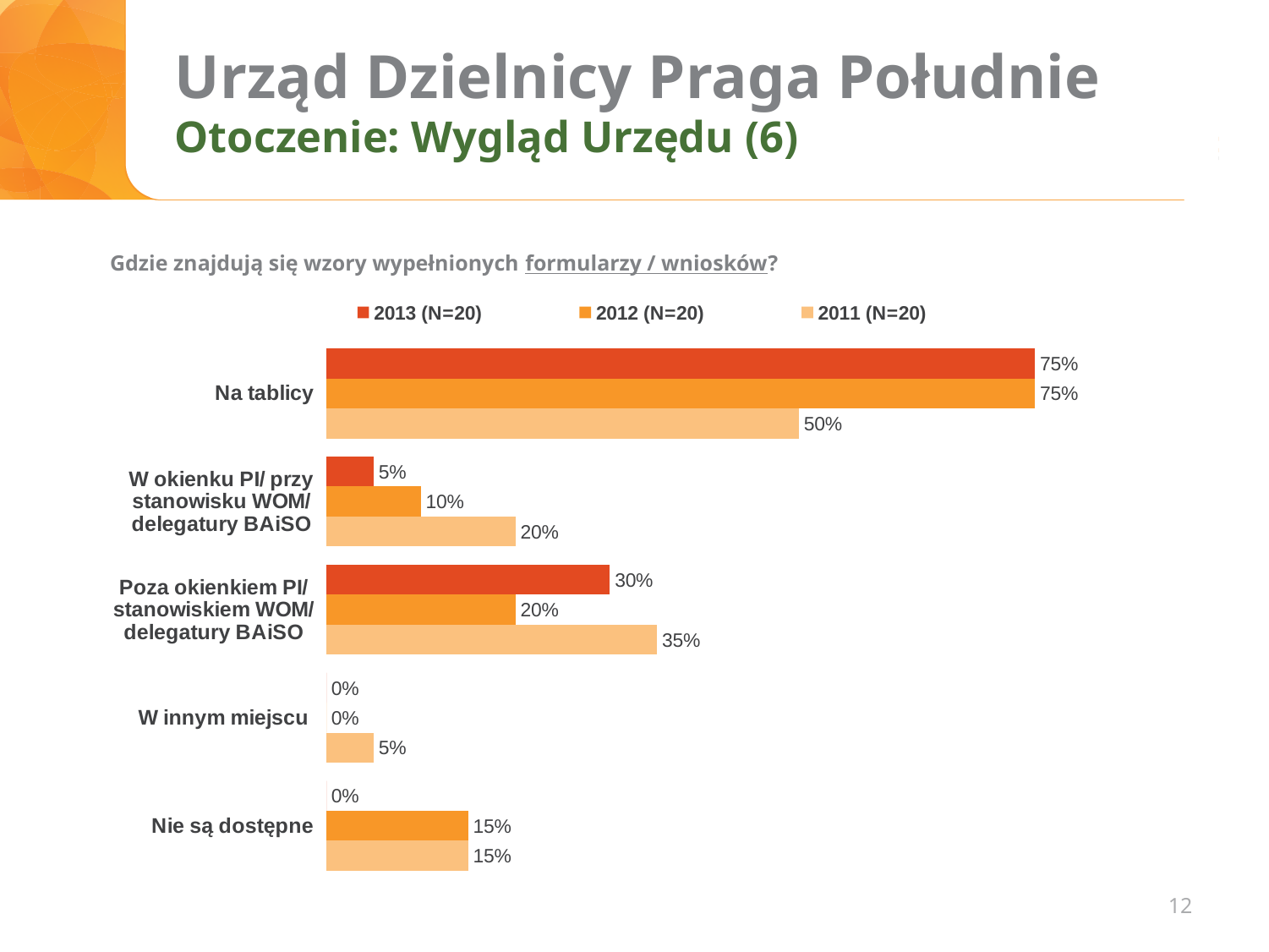
What question does the chart answer, according to the text above it? Gdzie znajdują się wzory wypełnionych formularzy / wniosków? What is the value for 'Na tablicy' in the 2013 (N=20) series? 75% What kind of chart is shown on the slide? Bar chart What is the difference between the 2011 (N=20) and 2013 (N=20) values for 'W okienku PI/ przy stanowisku WOM/ delegatury BAiSO'? 15% What is the value for 'Nie są dostępne' in the 2012 (N=20) series? 15% How many categories are shown on the chart? 5 What is the value for 'Poza okienkiem PI/ stanowiskiem WOM/ delegatury BAiSO' in the 2011 (N=20) series? 35% How many series does the legend list? 3 Which category has the highest value in the 2011 (N=20) series? Na tablicy What is the difference between the 2013 (N=20) and 2011 (N=20) values for 'Na tablicy'? 25% Which category has the lowest value in the 2011 (N=20) series? W innym miejscu Which is larger for 'Poza okienkiem PI/ stanowiskiem WOM/ delegatury BAiSO': the 2013 (N=20) value or the 2012 (N=20) value? 2013 (N=20)